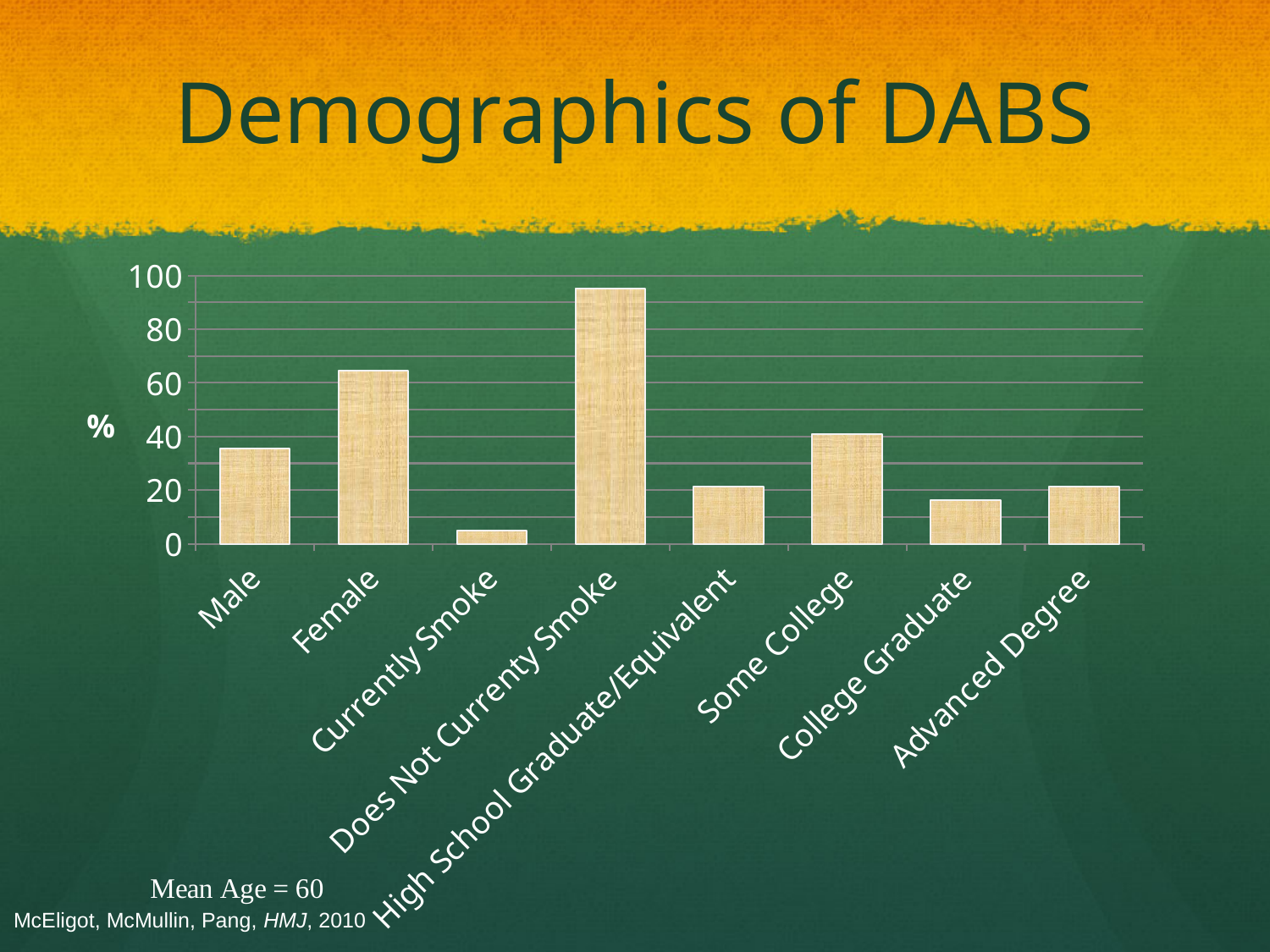
What is the title of the slide containing the chart? Demographics of DABS Which category has the lowest value? Currently Smoke Which is larger, the value for Some College or the value for College Graduate? Some College Is the value for Male greater or less than 40? less What is the label on the vertical axis of the chart? % Which category has the highest value? Does Not Currently Smoke How many categories are plotted on the chart? 8 Is the value for Currently Smoke greater or less than 20? less Is the value for Does Not Currently Smoke greater or less than 80? greater What kind of chart is shown on the slide? bar chart Which is larger, the value for Male or the value for Female? Female